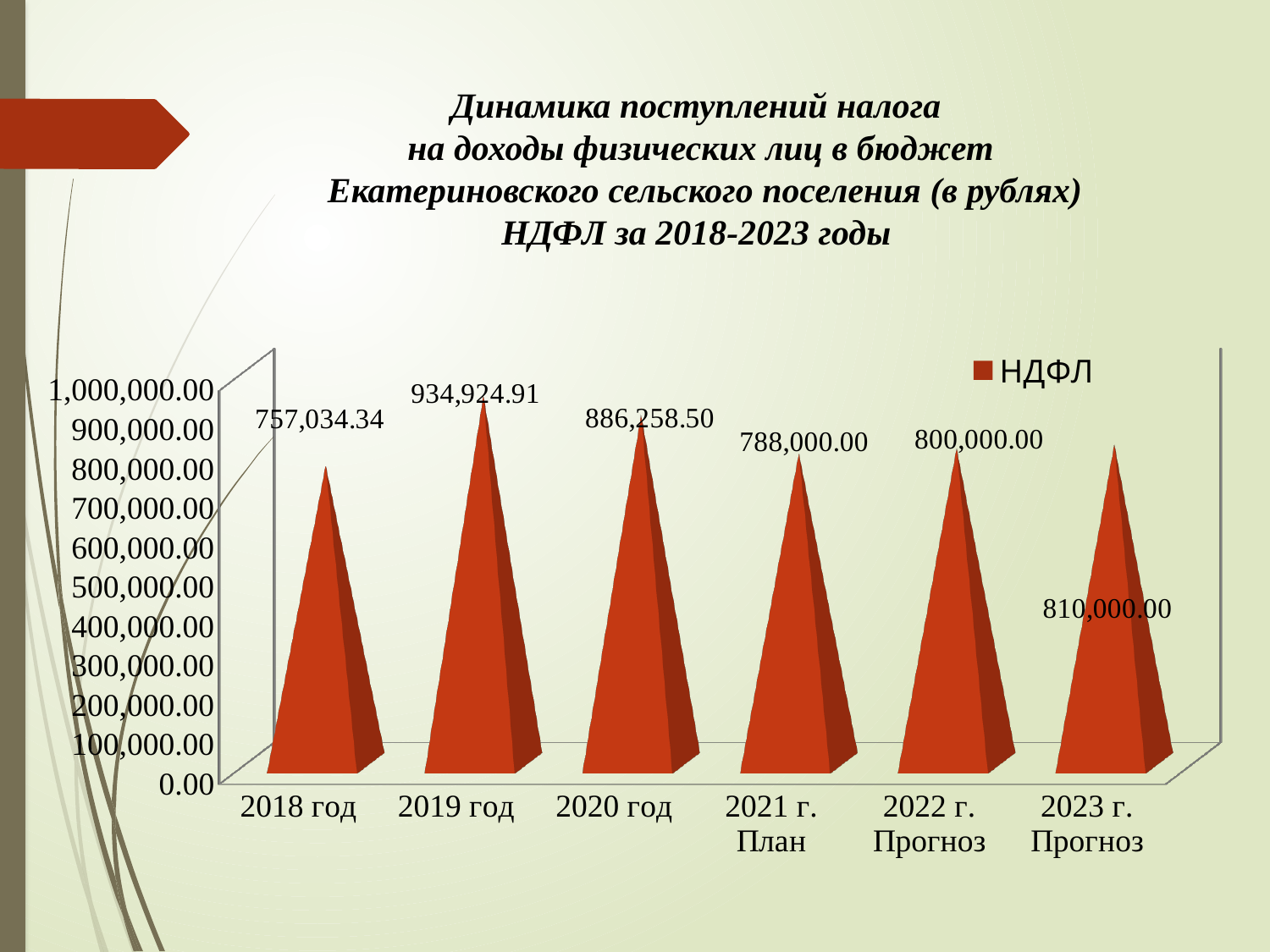
What is the difference between the values for 2023 г. Прогноз and 2022 г. Прогноз? 10,000.00 What is the difference between the values for 2019 год and 2020 год? 48,666.41 How many series does the legend list? 1 Do the values rise or fall from 2021 г. План to 2023 г. Прогноз? Rise Which category has the lowest value? 2018 год What is the value for 2020 год? 886,258.50 What is the value for 2022 г. Прогноз? 800,000.00 What is the value for 2018 год? 757,034.34 What kind of chart is shown on the slide? Bar chart Which category has the highest value? 2019 год How many categories are shown on the x axis? 6 Which is larger, the value for 2021 г. План or the value for 2018 год? 2021 г. План